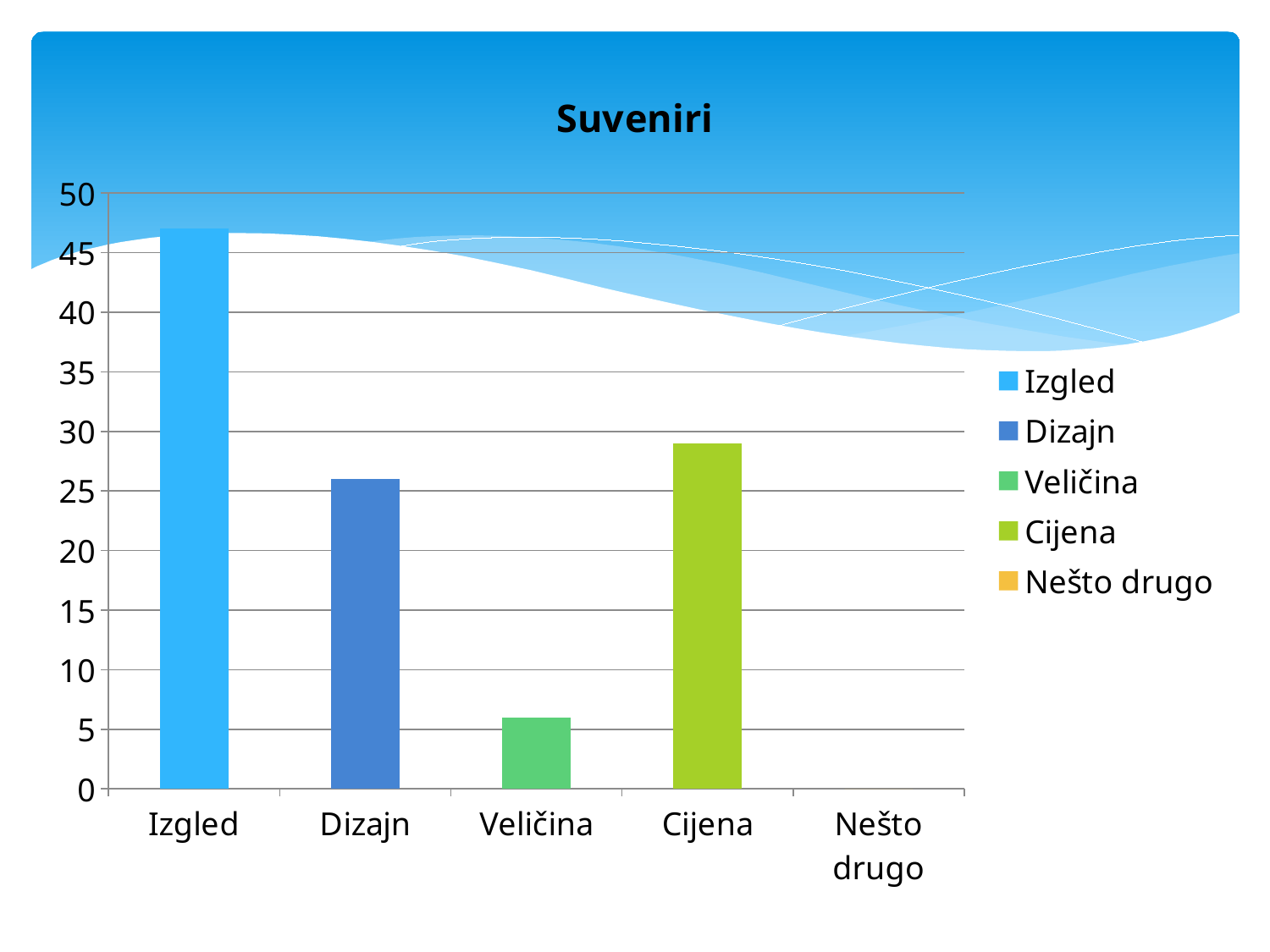
Which category has the highest value? Izgled Is the value for Izgled greater or less than 45? greater What kind of chart is shown on the slide? bar chart Is the value for Cijena greater or less than 30? less How many entries does the legend list? 5 Is the value for Dizajn greater or less than 25? greater Which category has the lowest value? Nešto drugo Which is larger, the value for Cijena or the value for Dizajn? Cijena Which is larger, the value for Veličina or the value for Dizajn? Dizajn What is the title of the chart? Suveniri How many categories are shown on the x axis? 5